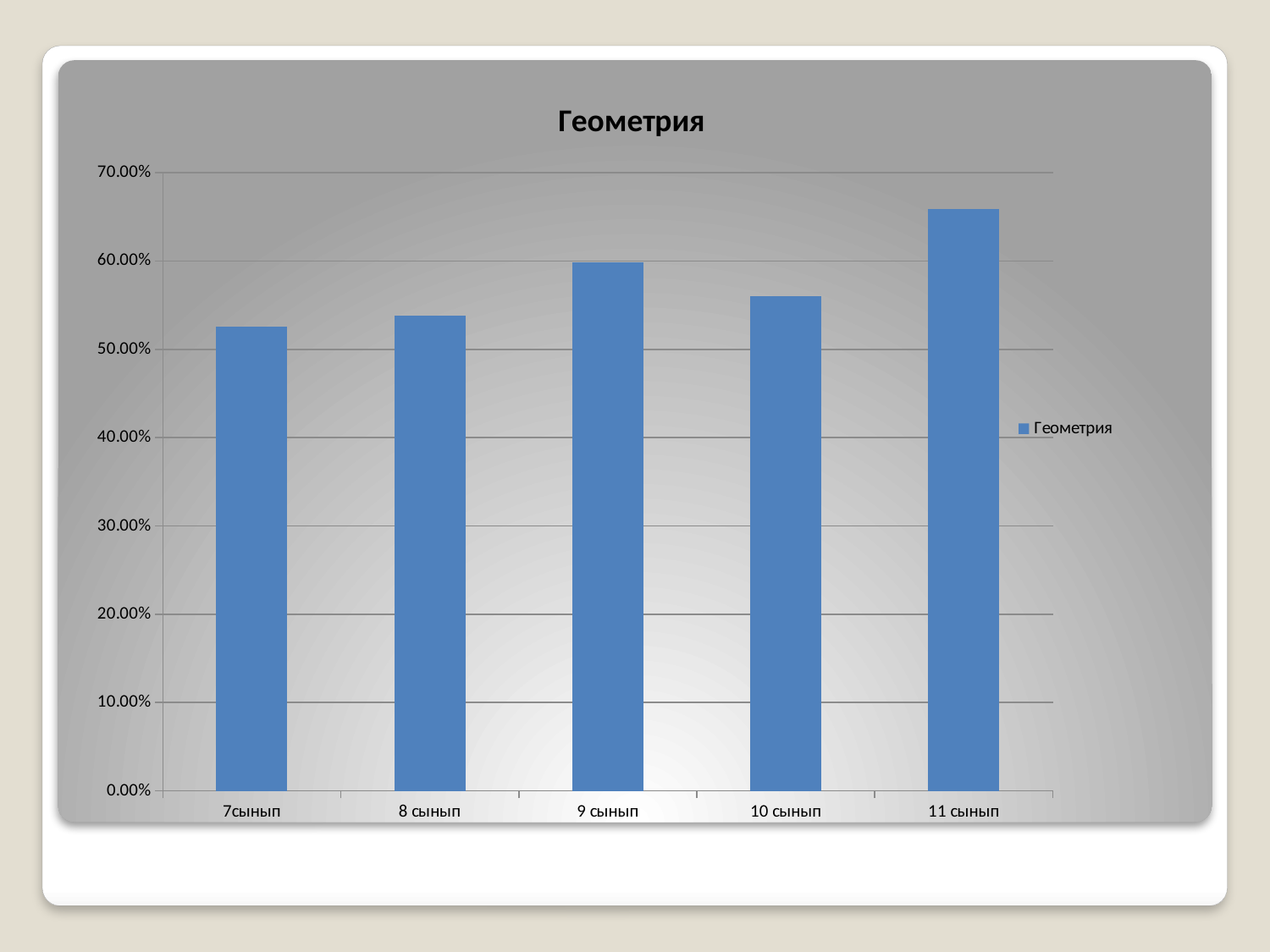
What type of chart is shown on the slide? bar chart Is the value for 10 сынып greater or less than 60.00%? less Which has the larger value, 9 сынып or 10 сынып? 9 сынып Which category has the highest value? 11 сынып What is the title of the chart? Геометрия Do the values rise or fall from 7сынып to 9 сынып? rise Which category has the lowest value? 7сынып Is the value for 8 сынып greater or less than 60.00%? less Is the value for 11 сынып greater or less than 60.00%? greater How many series does the legend list? 1 How many categories are shown on the x axis of the chart? 5